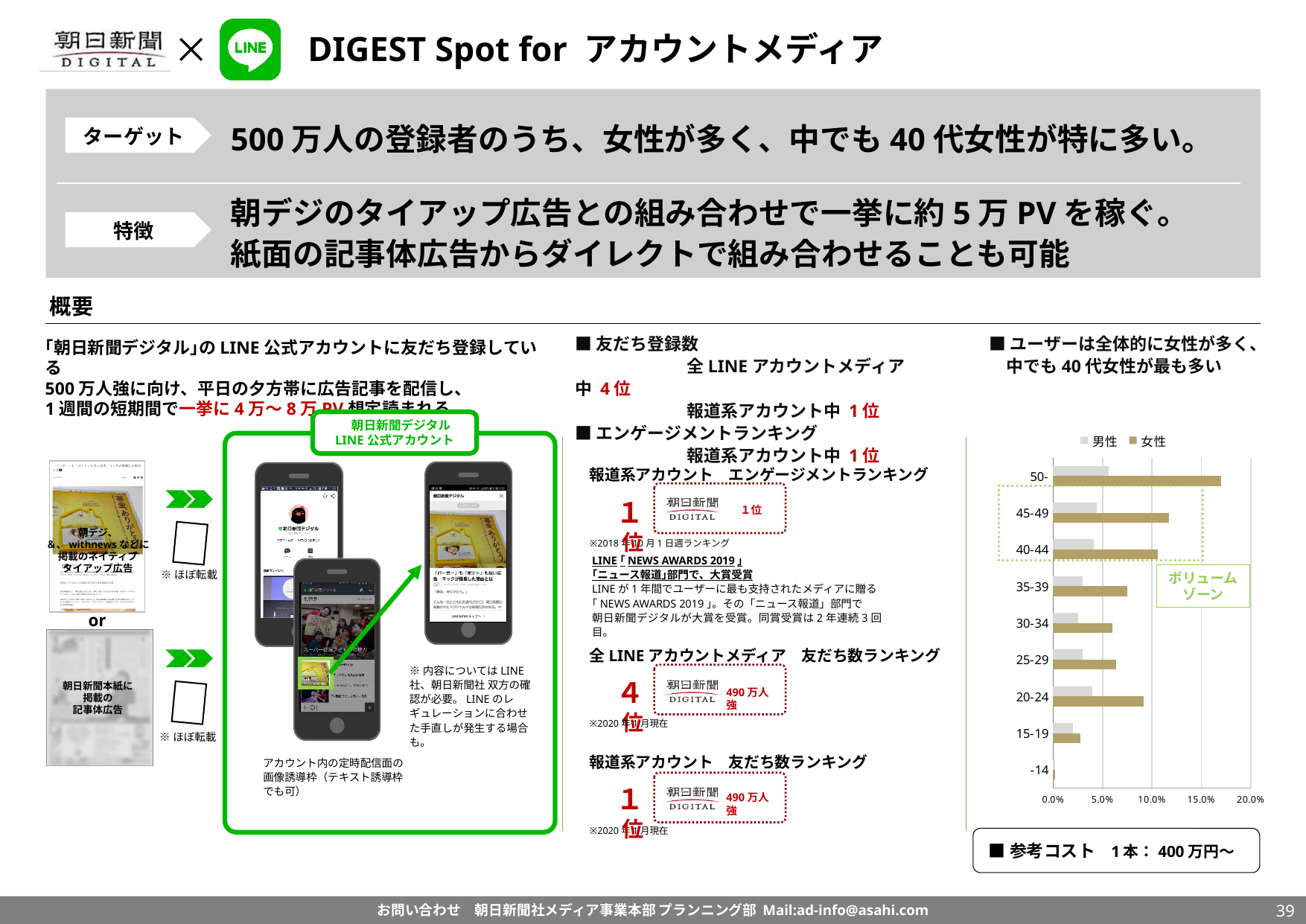
Which age group has the lowest value for 女性 in the bar chart? -14 Which age group has the highest value for 女性 in the bar chart? 50- What kind of chart is shown on the right side of the slide? bar chart How many series does the legend of the bar chart list? 2 Which age group has the highest value for 男性 in the bar chart? 50- In the bar chart, is the 男性 value for 50- greater or less than 10.0%? less In the bar chart, is the 女性 value for 50- greater or less than 15.0%? greater In the bar chart, which series is shown in the darker tan colour, 男性 or 女性? 女性 In the bar chart, is the 女性 value for 45-49 greater or less than 10.0%? greater How many age-group categories does the bar chart on the right show? 9 In the bar chart, which is larger for the 50- age group, 男性 or 女性? 女性